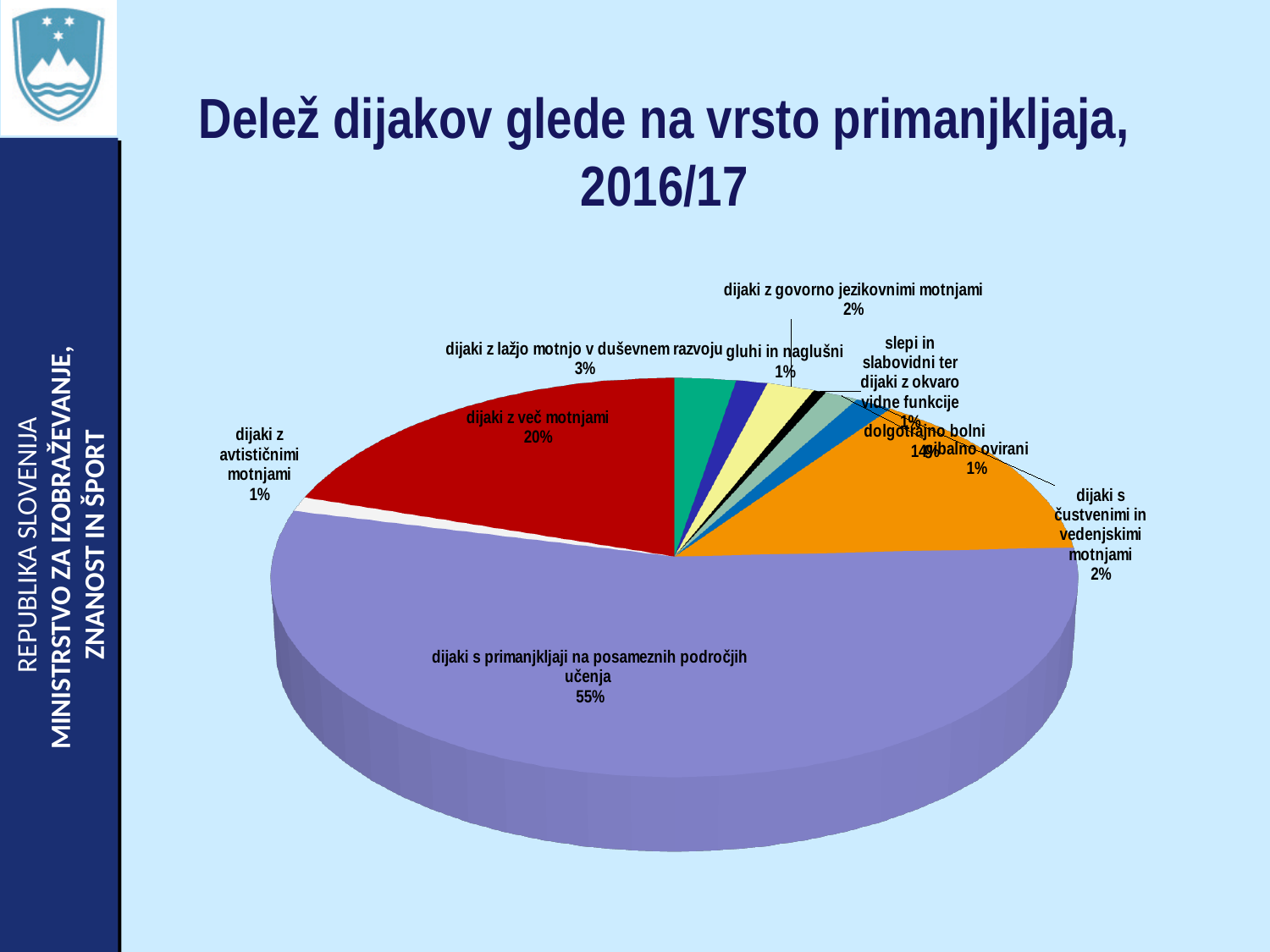
Which category has the largest share of the pie? dijaki s primanjkljaji na posameznih področjih učenja What is the value for 'dijaki z govorno jezikovnimi motnjami'? 2% What share of the pie is 'dijaki s primanjkljaji na posameznih področjih učenja'? 55% What is the value for 'dijaki z več motnjami'? 20% What is the value for 'dijaki z lažjo motnjo v duševnem razvoju'? 3% What is the value for 'dijaki s čustvenimi in vedenjskimi motnjami'? 2% What is the title of the chart? Delež dijakov glede na vrsto primanjkljaja, 2016/17 Which is larger, 'dijaki z več motnjami' or 'dijaki z lažjo motnjo v duševnem razvoju'? dijaki z več motnjami What is the value for 'dijaki z avtističnimi motnjami'? 1% What is the difference between 'dijaki s primanjkljaji na posameznih področjih učenja' and 'dijaki z več motnjami'? 35% What kind of chart is shown on the slide? pie chart How many categories (slices) does the pie chart have? 10